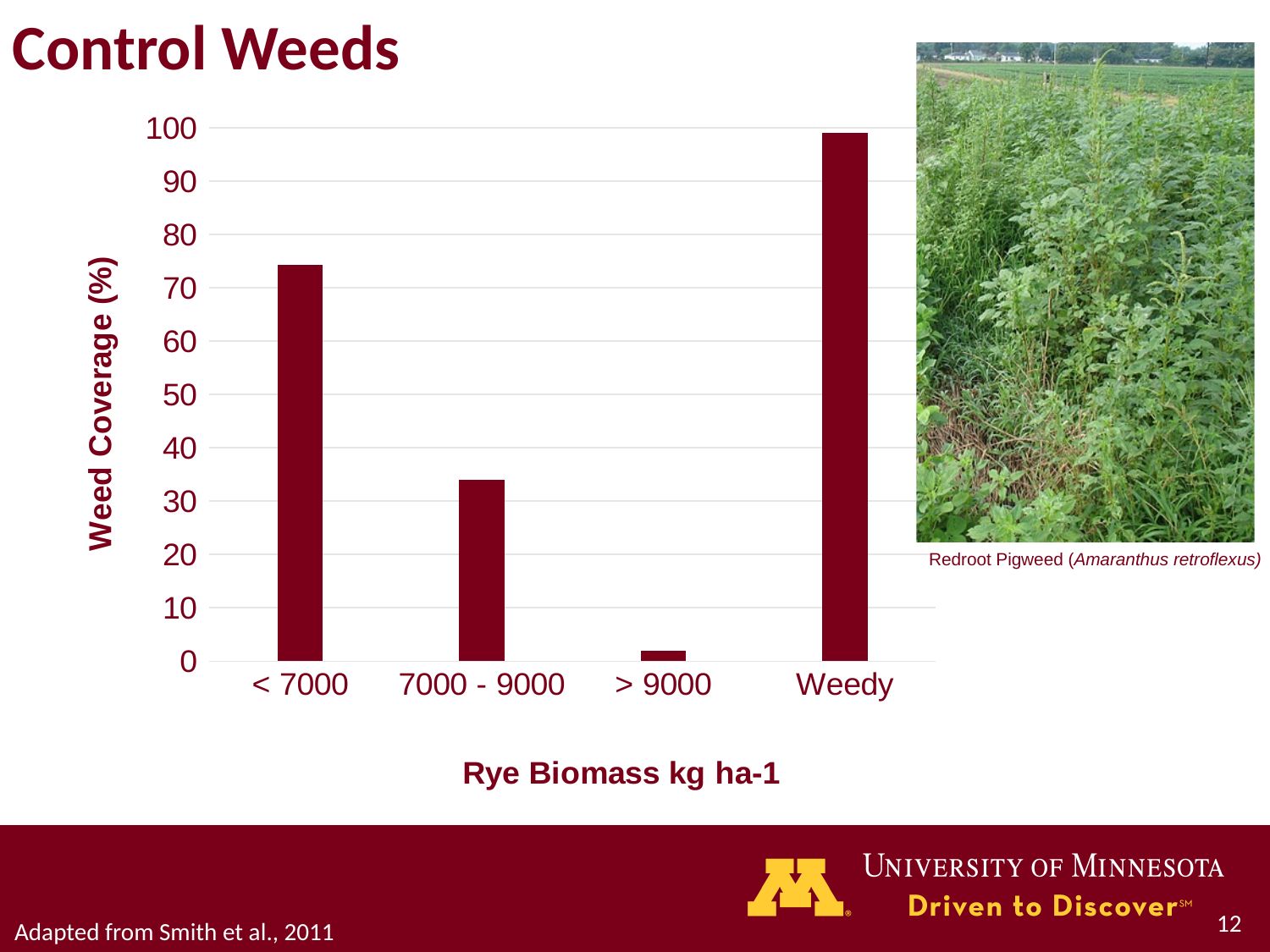
Is the weed coverage for < 7000 greater or less than 70? greater What kind of chart is shown on the slide? bar chart Which has higher weed coverage, < 7000 or 7000 - 9000? < 7000 Which category has the lowest weed coverage? > 9000 What is the label of the x axis of the chart? Rye Biomass kg ha-1 What is the label of the y axis of the chart? Weed Coverage (%) Which has lower weed coverage, > 9000 or Weedy? > 9000 Is the weed coverage for > 9000 greater or less than 10? less Is the weed coverage for 7000 - 9000 greater or less than 40? less Which category has the highest weed coverage? Weedy How many categories are shown on the x axis of the chart? 4